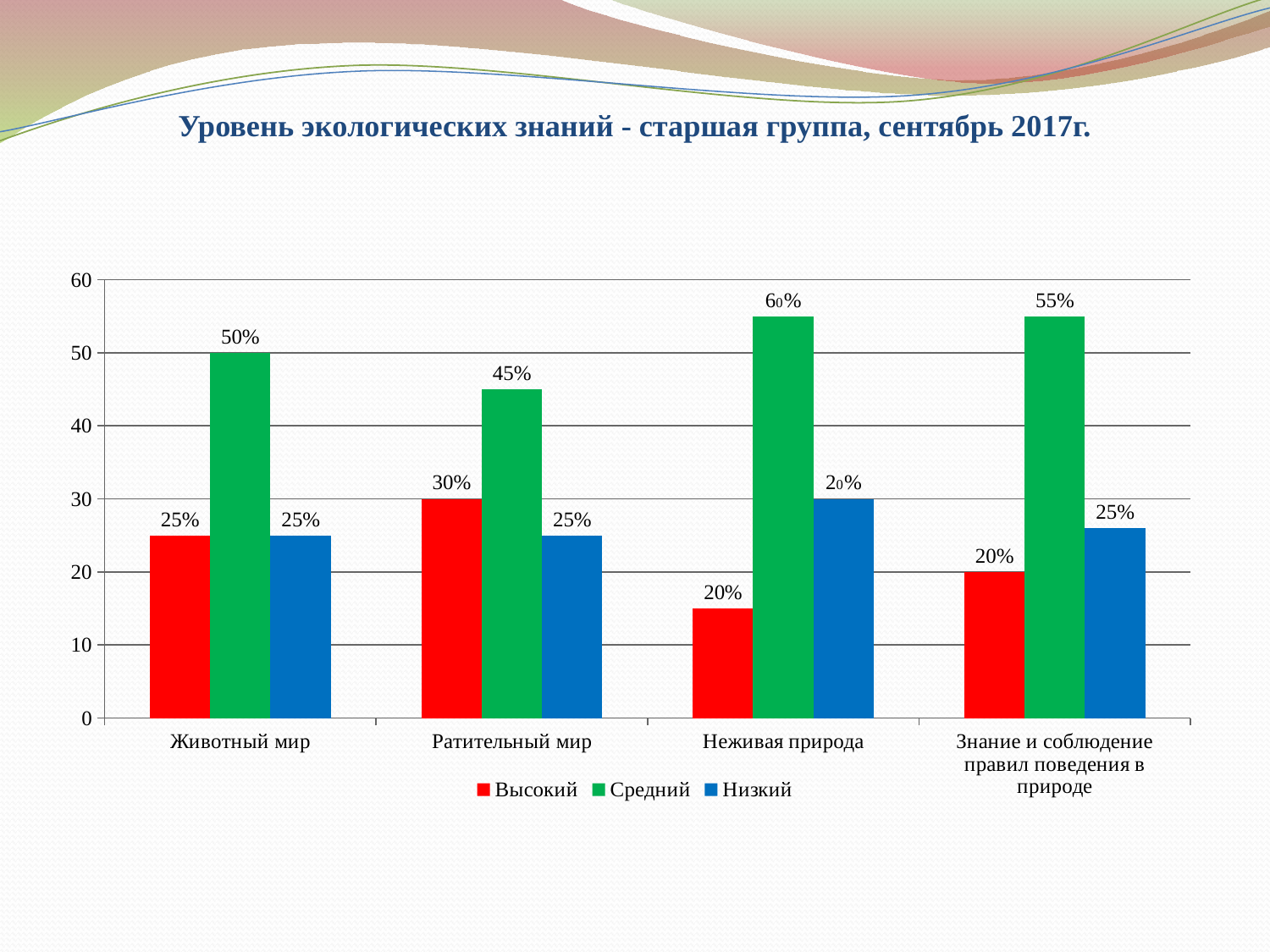
What is the value for Высокий in the Ратительный мир category? 30% What is the difference between the Средний and Высокий values in the Животный мир category? 25 percentage points How many categories are shown on the x axis? 4 What is the value for Низкий in the Знание и соблюдение правил поведения в природе category? 25% How many series does the legend list? 3 Which colour represents the Низкий series in the legend? Blue Is the Средний value for Ратительный мир greater or less than 40? greater Which is larger: the Средний value for Животный мир or the Средний value for Ратительный мир? Животный мир Which category has the highest value for the Высокий series? Ратительный мир Which category has the lowest value for the Средний series? Ратительный мир What is the value for Средний in the Животный мир category? 50% What kind of chart is shown on the slide? Bar chart